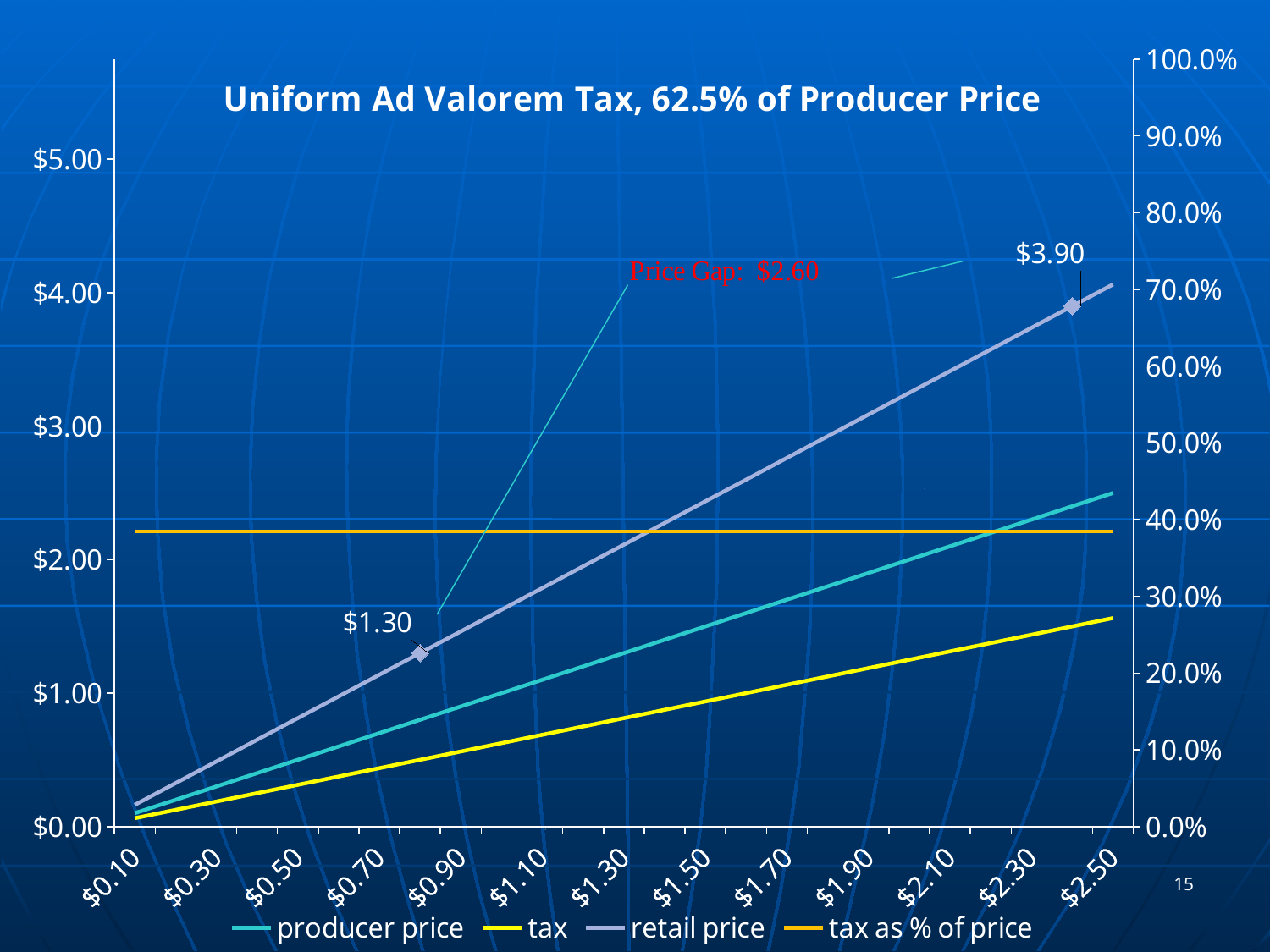
At $2.50 on the x-axis, is the tax value greater or less than $2.00? less Which series is the lowest line at the right end of the chart ($2.50)? tax What is the difference between the two labeled retail price values, $3.90 and $1.30? $2.60 What kind of chart is shown on the slide? line chart What is the title of the chart? Uniform Ad Valorem Tax, 62.5% of Producer Price How many tick labels are shown on the x-axis? 13 Does the retail price line rise or fall as the x-axis value increases? rise What is the higher of the two labeled values on the retail price line? $3.90 At $2.50 on the x-axis, is the producer price greater or less than $2.00? greater What is the lower of the two labeled values on the retail price line? $1.30 How many series does the legend list? 4 Which series is the highest line at the right end of the chart ($2.50)? retail price